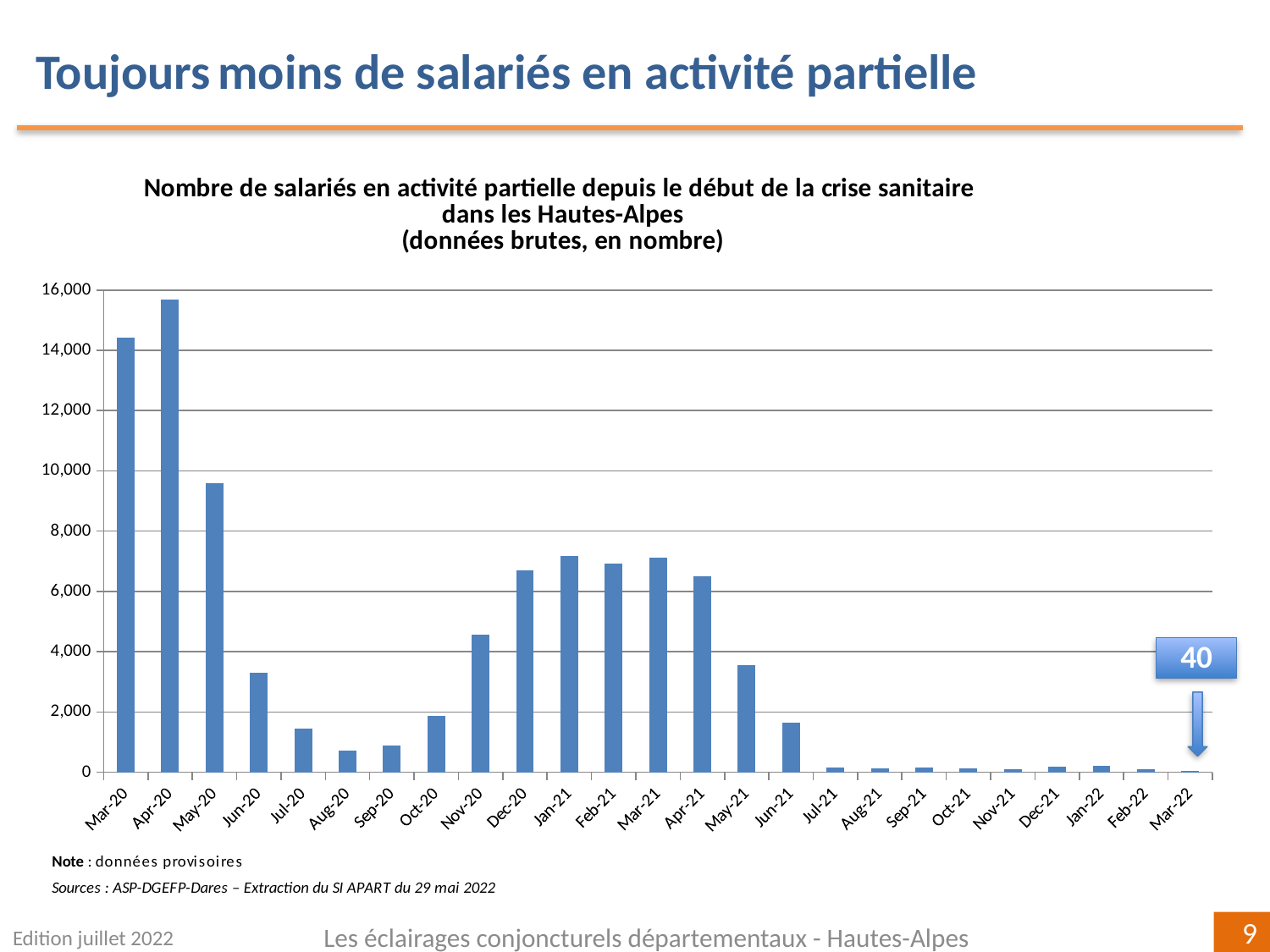
What kind of chart is shown on the slide? bar chart Is the value for May-20 greater or less than 10,000? less Which is larger, the value for Apr-20 or the value for May-20? Apr-20 What is the number of employees in partial activity shown for Mar-22? 40 Which month has the highest number of employees in partial activity? Apr-20 How many months are plotted on the x axis? 25 What is the title of the chart? Nombre de salariés en activité partielle depuis le début de la crise sanitaire dans les Hautes-Alpes (données brutes, en nombre) Is the value for Jun-21 greater or less than 2,000? less Is the value for Dec-20 greater or less than 6,000? greater Which month has the lowest number of employees in partial activity? Mar-22 Do the values rise or fall from Mar-20 to Aug-20? fall